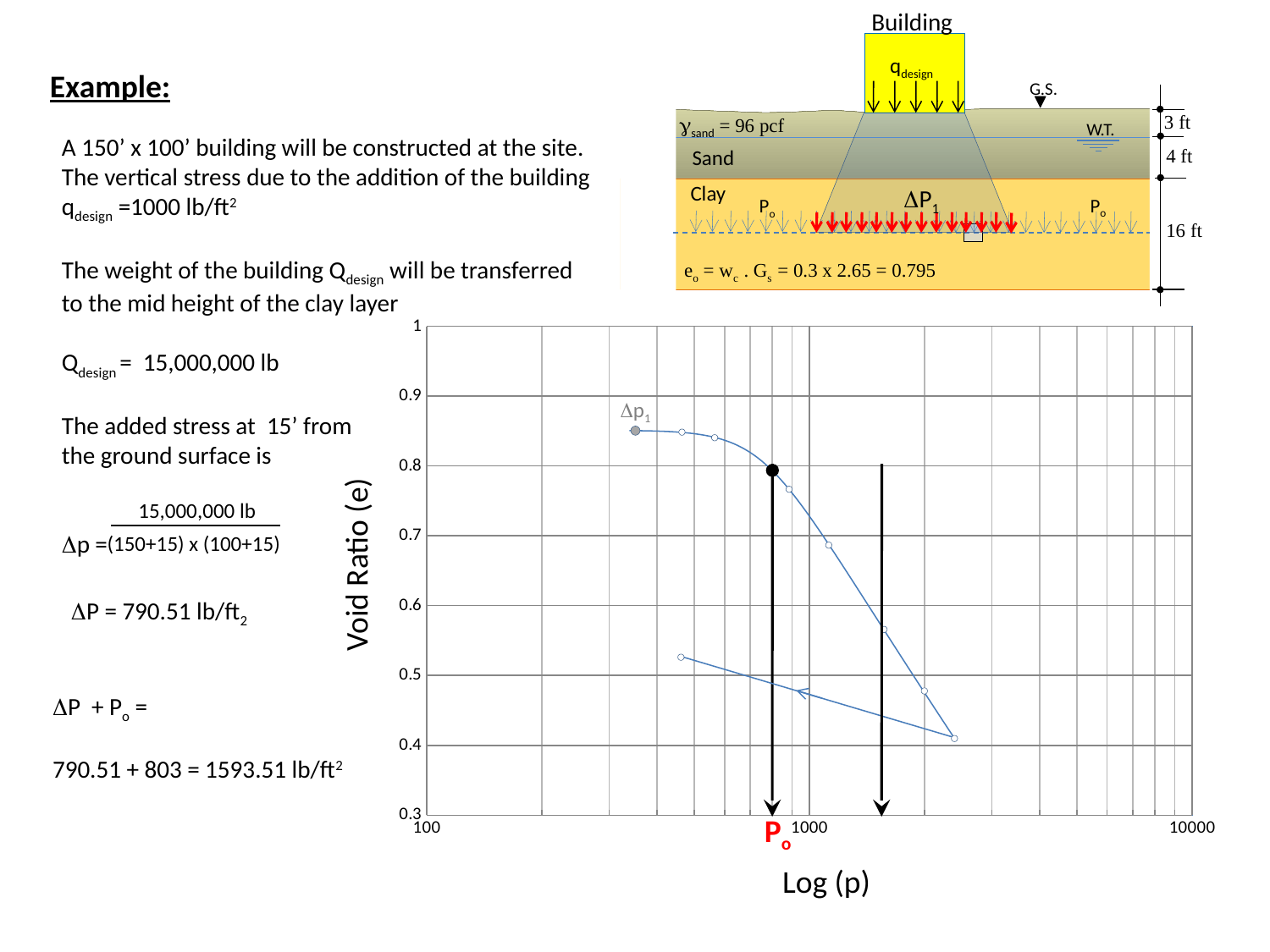
What is the lowest value shown on the vertical axis of the chart? 0.3 Is the void ratio at the black dot marked Po greater or less than 0.7? greater Is the lowest void ratio reached on the curve greater or less than 0.5? less Is the void ratio at the point labelled Δp1 greater or less than 0.8? greater What is the title of the horizontal axis of the chart? Log (p) Is the void ratio at the point labelled Δp1 larger or smaller than the void ratio at the black dot marked Po? larger What is the title of the vertical axis of the chart? Void Ratio (e) What kind of chart is shown on the slide? line chart Along the loading curve, does the void ratio rise or fall as the pressure p increases? fall Which labelled point on the chart has the highest void ratio? Δp1